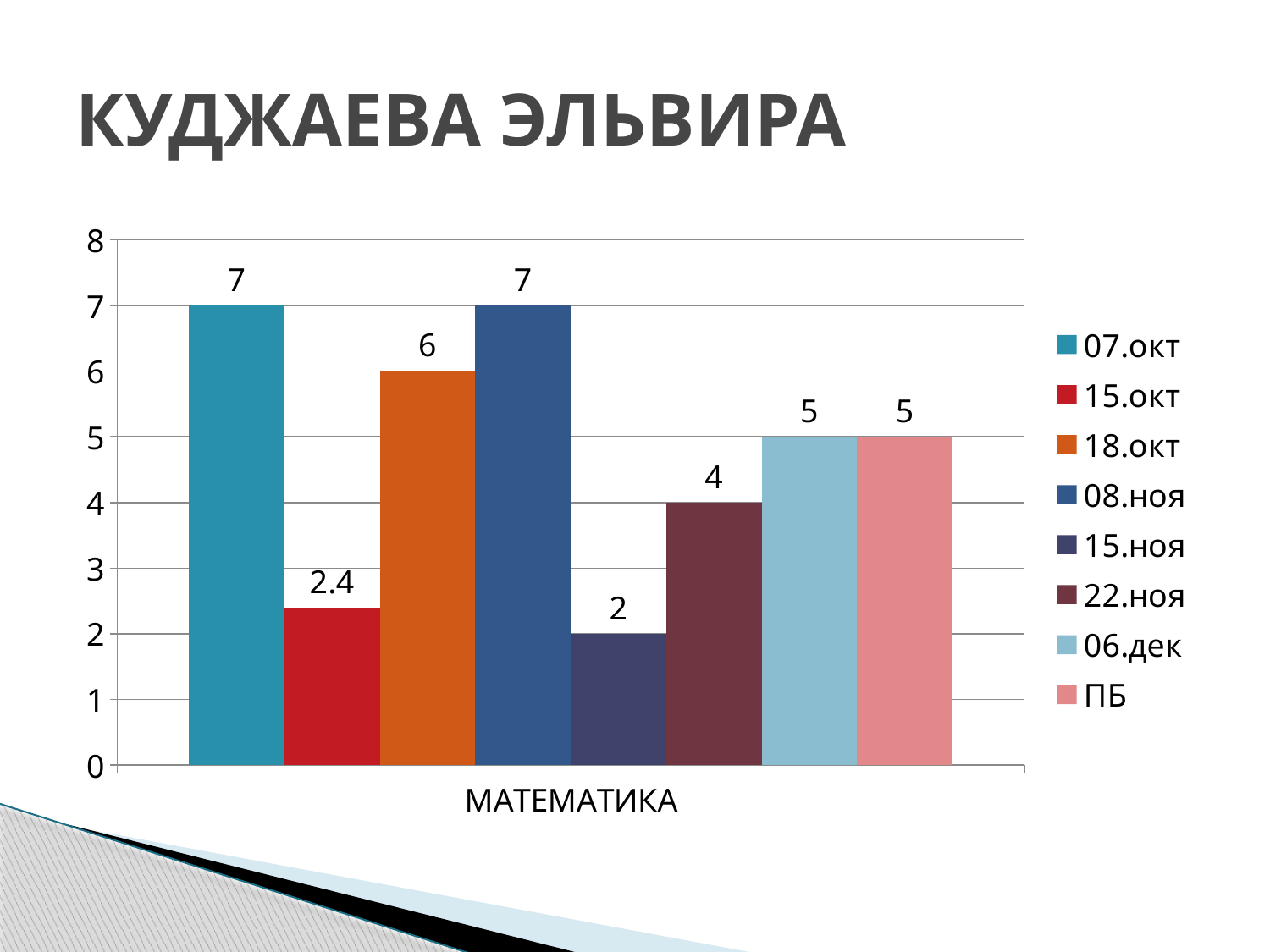
What is the value for the 22.ноя series? 4 Which series has the lowest value? 15.ноя What is the category label on the x axis? МАТЕМАТИКА What is the title of the slide? КУДЖАЕВА ЭЛЬВИРА What is the value for the 15.окт series in the МАТЕМАТИКА category? 2.4 What is the difference between the 07.окт value and the 15.окт value? 4.6 Which is larger, the value for 22.ноя or the value for 15.ноя? 22.ноя Which is larger, the value for 18.окт or the value for 06.дек? 18.окт What kind of chart is shown on the slide? bar chart What is the difference between the 18.окт value and the 15.ноя value? 4 How many series does the legend list? 8 What is the value for the ПБ series? 5